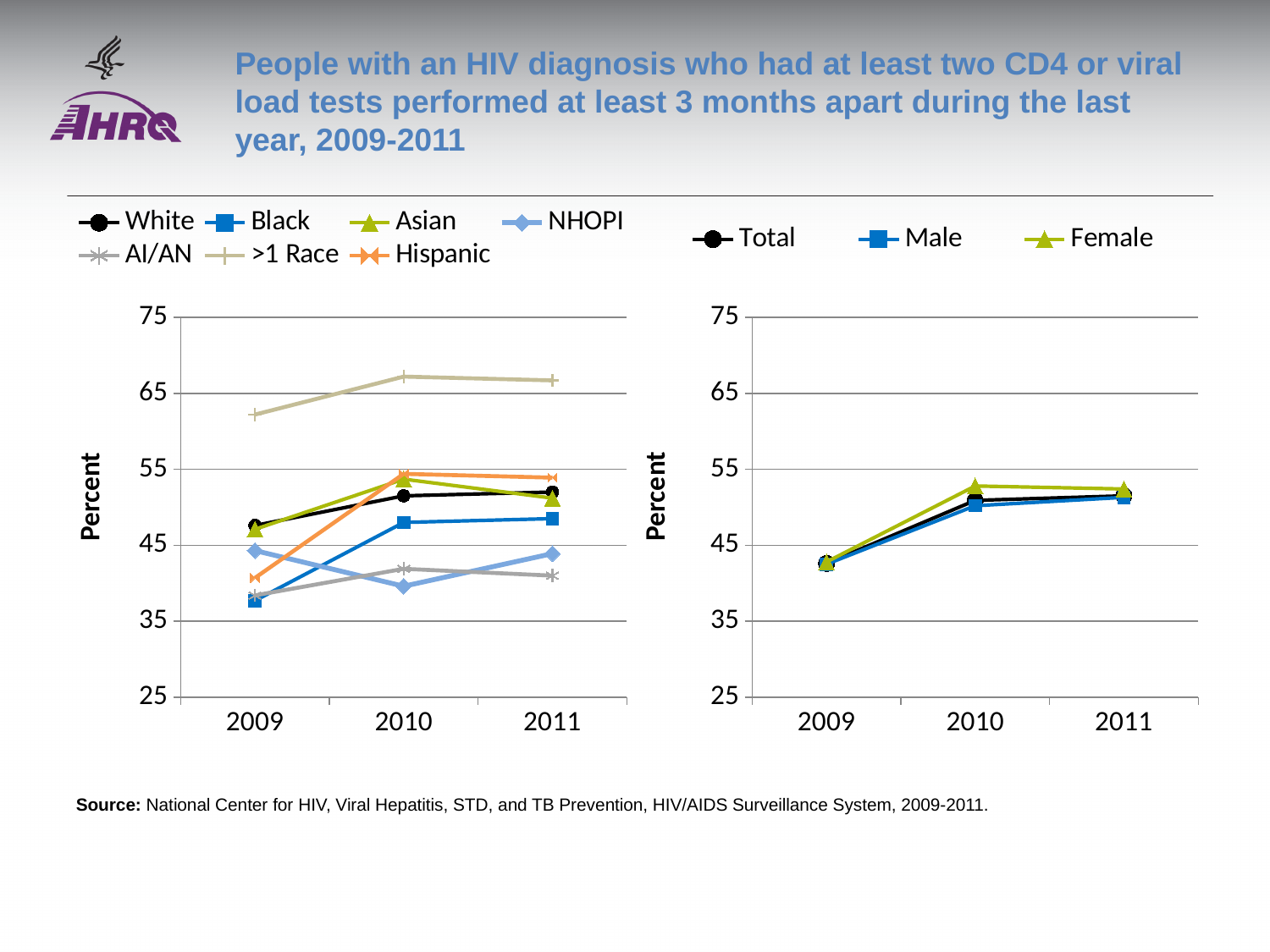
What is the label on the y axis of the right chart? Percent In the left chart, which series has the lowest value in 2010? NHOPI In the right chart, does the Total series rise or fall from 2009 to 2011? rise In the left chart, is the value for Hispanic in 2009 greater or less than 45? less In the left chart, which is larger in 2010, the value for Hispanic or the value for Black? Hispanic What kind of chart is the left chart on the slide? line chart In the left chart, is the value for >1 Race in 2010 greater or less than 65? greater In the right chart, is the value for Total in 2009 greater or less than 45? less In the left chart, which series has the highest value in 2010? >1 Race How many series does the legend of the right chart list? 3 How many series does the legend of the left chart list? 7 How many years are shown on the x axis of the right chart? 3